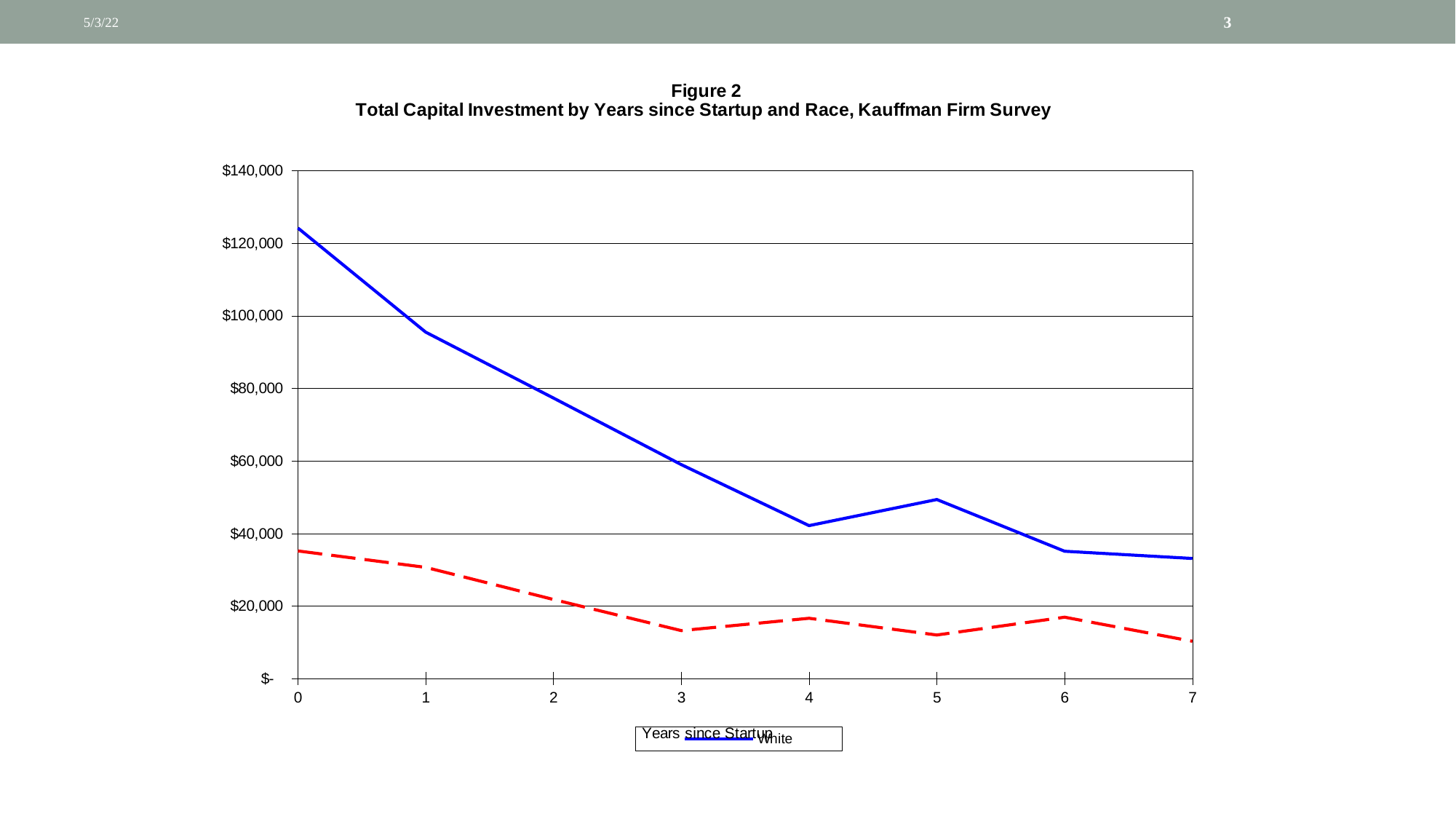
Which is larger for the White series: the value at year 4 or the value at year 5? year 5 Is the value for White at year 5 greater or less than $60,000? less What is the label of the x axis? Years since Startup Is the value for White at year 0 greater or less than $100,000? greater How many years since startup are plotted along the x axis? 8 What kind of chart is shown on the slide? line chart At which year since startup is the White series highest? 0 Which is larger for the White series: the value at year 0 or the value at year 7? year 0 Is the value for White at year 1 greater or less than $100,000? less Does the White series generally rise or fall as years since startup increase? fall What is the title of the chart? Figure 2 Total Capital Investment by Years since Startup and Race, Kauffman Firm Survey